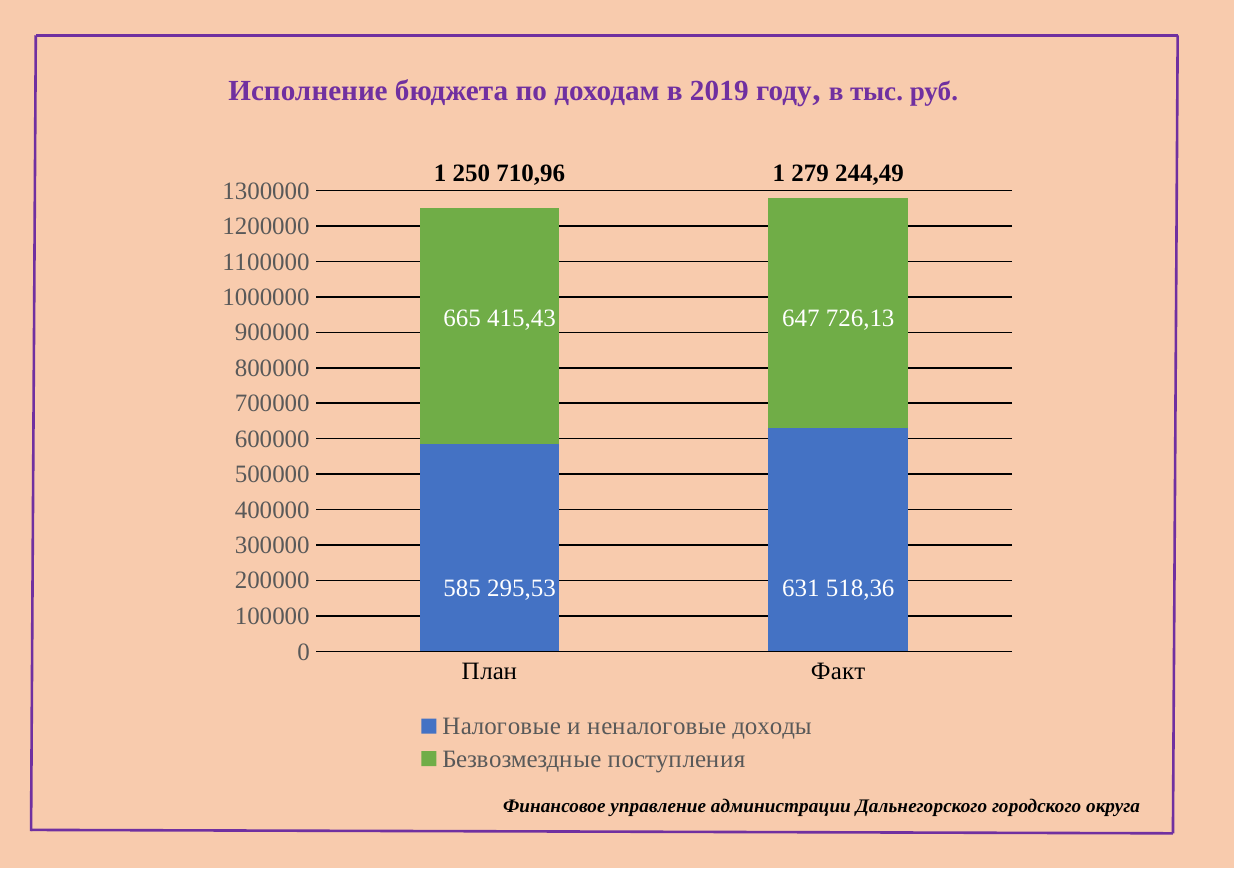
What is the value of Налоговые и неналоговые доходы for План? 585 295,53 What is the value of Налоговые и неналоговые доходы for Факт? 631 518,36 What is the value of Безвозмездные поступления for Факт? 647 726,13 What is the total of the stacked bar for Факт? 1 279 244,49 What is the title of the chart? Исполнение бюджета по доходам в 2019 году, в тыс. руб. What is the difference between the Налоговые и неналоговые доходы values for Факт and План? 46 222,83 Which category has the higher total, План or Факт? Факт How many categories are shown on the x axis? 2 How many series does the legend list? 2 What is the difference between the Безвозмездные поступления values for План and Факт? 17 689,30 What is the total of the stacked bar for План? 1 250 710,96 What type of chart is shown on the slide? Stacked bar chart